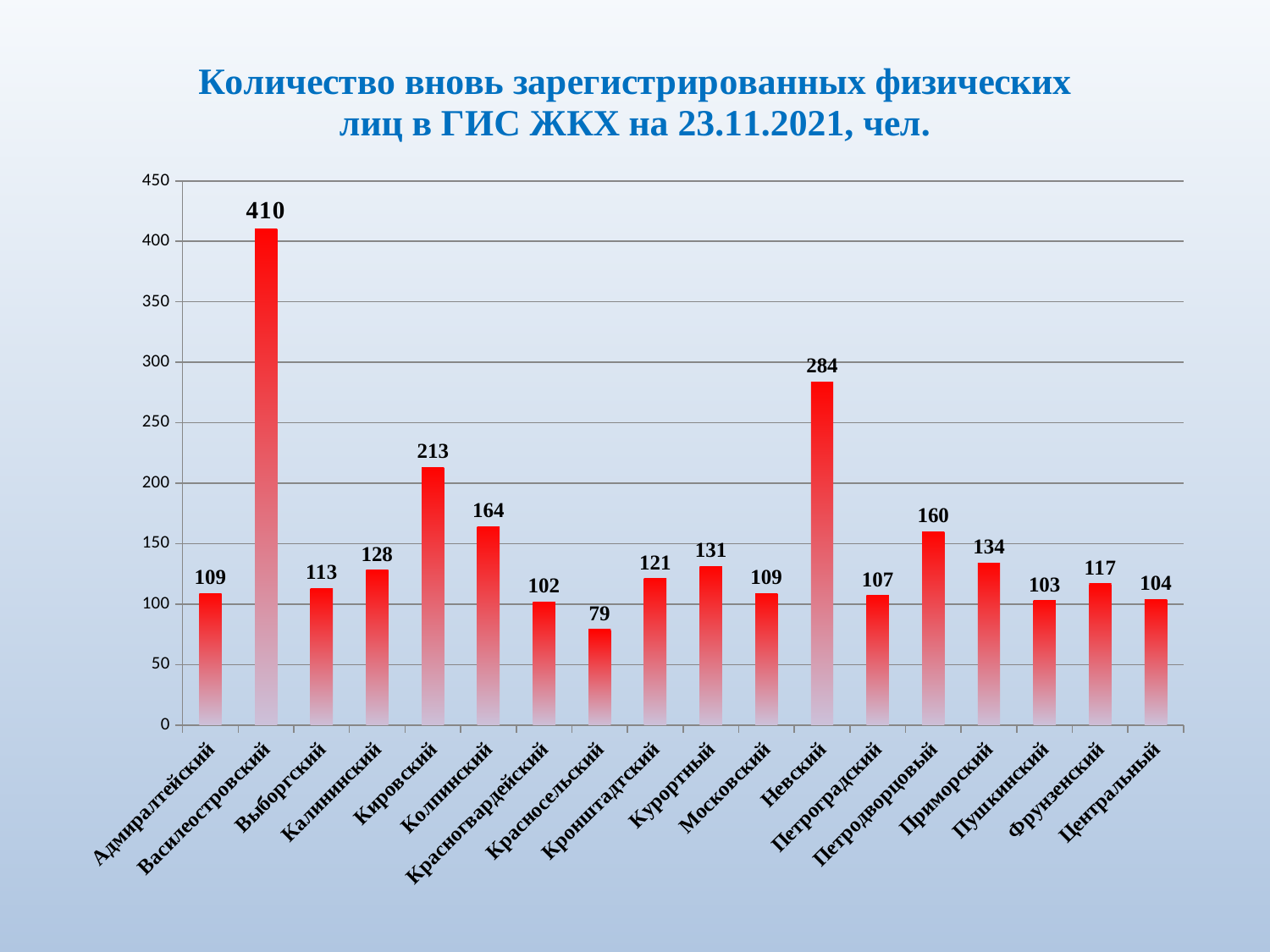
What is the value for Красносельский? 79 Which district has the lowest value? Красносельский What is the value for Петродворцовый? 160 What is the value for Василеостровский? 410 What is the difference between the values for Приморский and Пушкинский? 31 Which district has the highest value? Василеостровский What date is given in the chart title? 23.11.2021 How many districts are shown on the chart? 18 What is the value for Невский? 284 What kind of chart is shown on the slide? Bar chart Which is larger, the value for Кировский or the value for Колпинский? Кировский What is the difference between the values for Василеостровский and Невский? 126